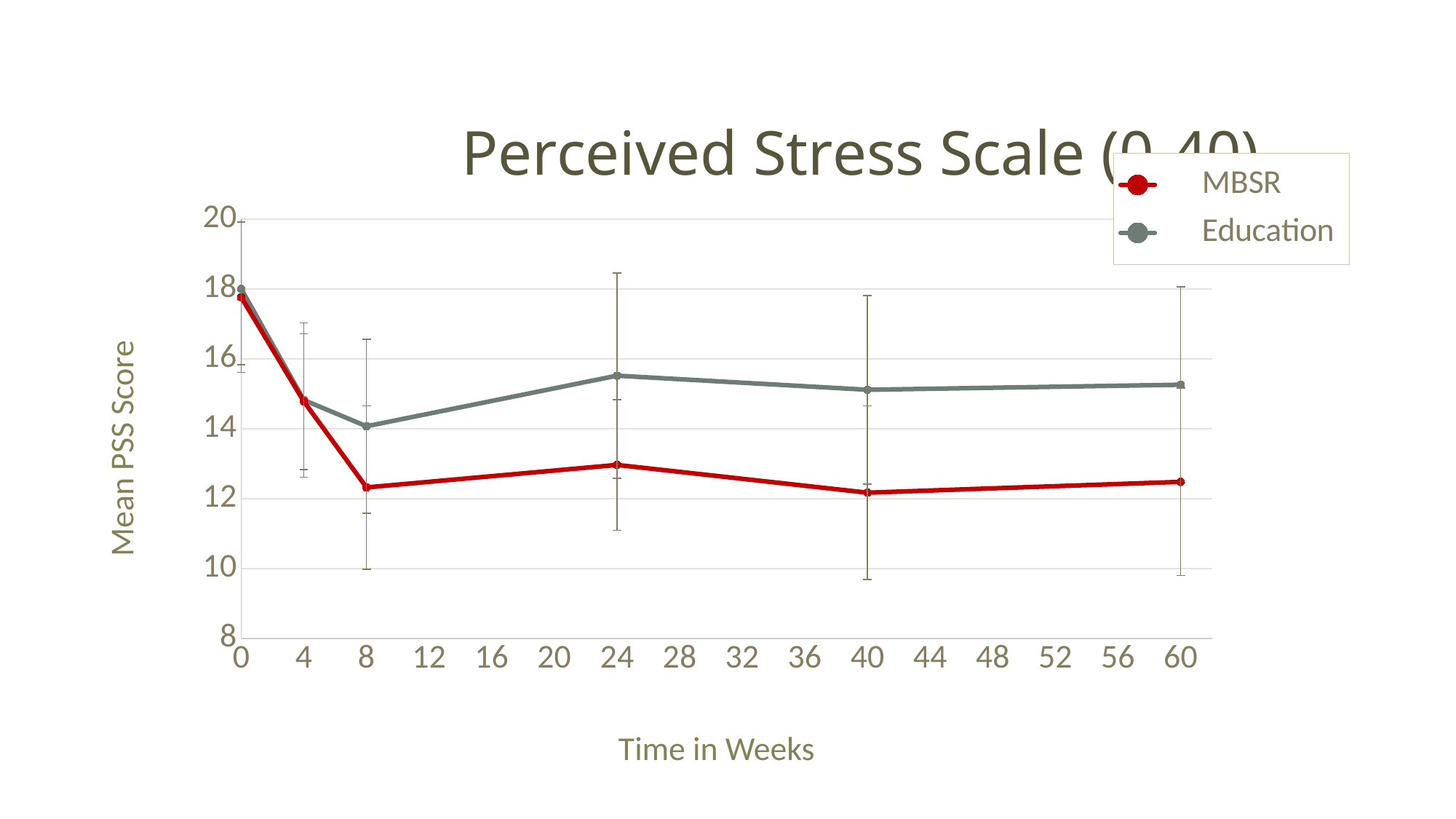
Is the MBSR value at week 8 greater or less than 14? less Which two series are listed in the legend? MBSR and Education How many series does the legend list? 2 Is the MBSR value at week 0 greater or less than 16? greater How many data points are plotted for the MBSR series? 6 At which week is the Education series at its lowest value? 8 At week 24, which series has the higher Mean PSS Score, MBSR or Education? Education Is the Education value at week 24 greater or less than 14? greater At which week is the MBSR series at its highest value? 0 What kind of chart is shown on the slide? line chart Does the MBSR series rise or fall between week 0 and week 8? fall What is the title of the vertical axis? Mean PSS Score